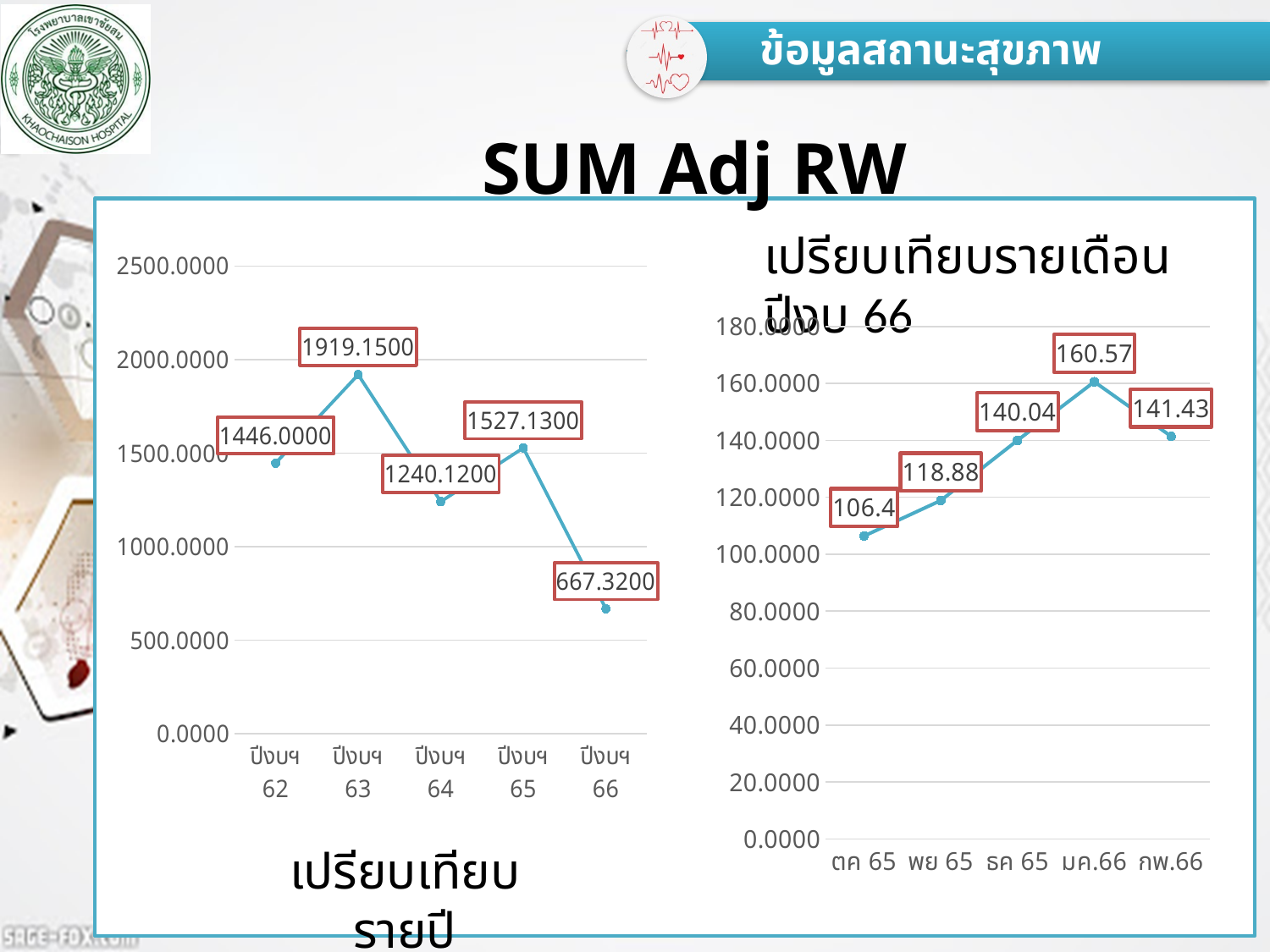
On the left chart (เปรียบเทียบรายปี), how many years are plotted? 5 On the right chart (เปรียบเทียบรายเดือน ปีงบ 66), which month has the highest value? มค.66 On the left chart (เปรียบเทียบรายปี), which year has the highest value? ปีงบฯ 63 On the right chart (เปรียบเทียบรายเดือน ปีงบ 66), what is the value for ตค 65? 106.4 On the left chart (เปรียบเทียบรายปี), what is the value for ปีงบฯ 63? 1919.1500 What type of chart is the left chart (เปรียบเทียบรายปี)? Line chart On the right chart (เปรียบเทียบรายเดือน ปีงบ 66), do the values rise or fall from ตค 65 to มค.66? Rise On the right chart (เปรียบเทียบรายเดือน ปีงบ 66), what is the value for มค.66? 160.57 On the right chart (เปรียบเทียบรายเดือน ปีงบ 66), which is larger, the value for ธค 65 or กพ.66? กพ.66 On the left chart (เปรียบเทียบรายปี), which year has the lowest value? ปีงบฯ 66 On the left chart (เปรียบเทียบรายปี), what is the value for ปีงบฯ 66? 667.3200 On the left chart (เปรียบเทียบรายปี), what is the difference between the values for ปีงบฯ 65 and ปีงบฯ 64? 287.0100